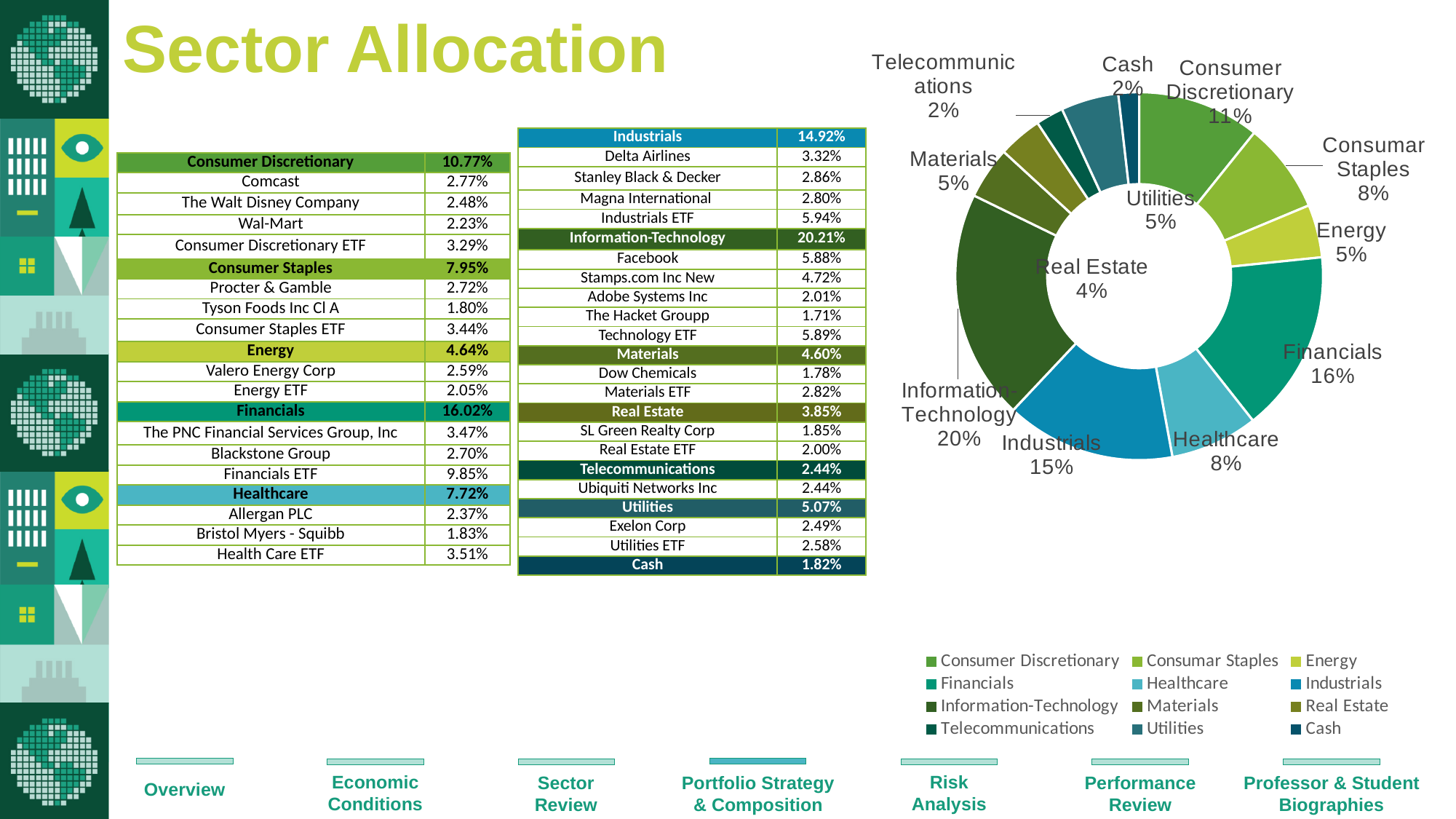
What percentage does the chart show for Cash? 2% What percentage does the chart show for Information-Technology? 20% What percentage does the chart show for Industrials? 15% Which sector has the largest share in the chart? Information-Technology What is the title of the slide containing the chart? Sector Allocation What percentage does the chart show for Real Estate? 4% What is the difference in percentage points between Information-Technology and Industrials in the chart? 5 Which sector has a larger share in the chart, Financials or Healthcare? Financials What type of chart is shown on the slide? Doughnut chart What percentage does the chart show for Financials? 16% What is the combined share of Consumer Discretionary and Consumar Staples in the chart? 19% How many sectors does the chart's legend list? 12